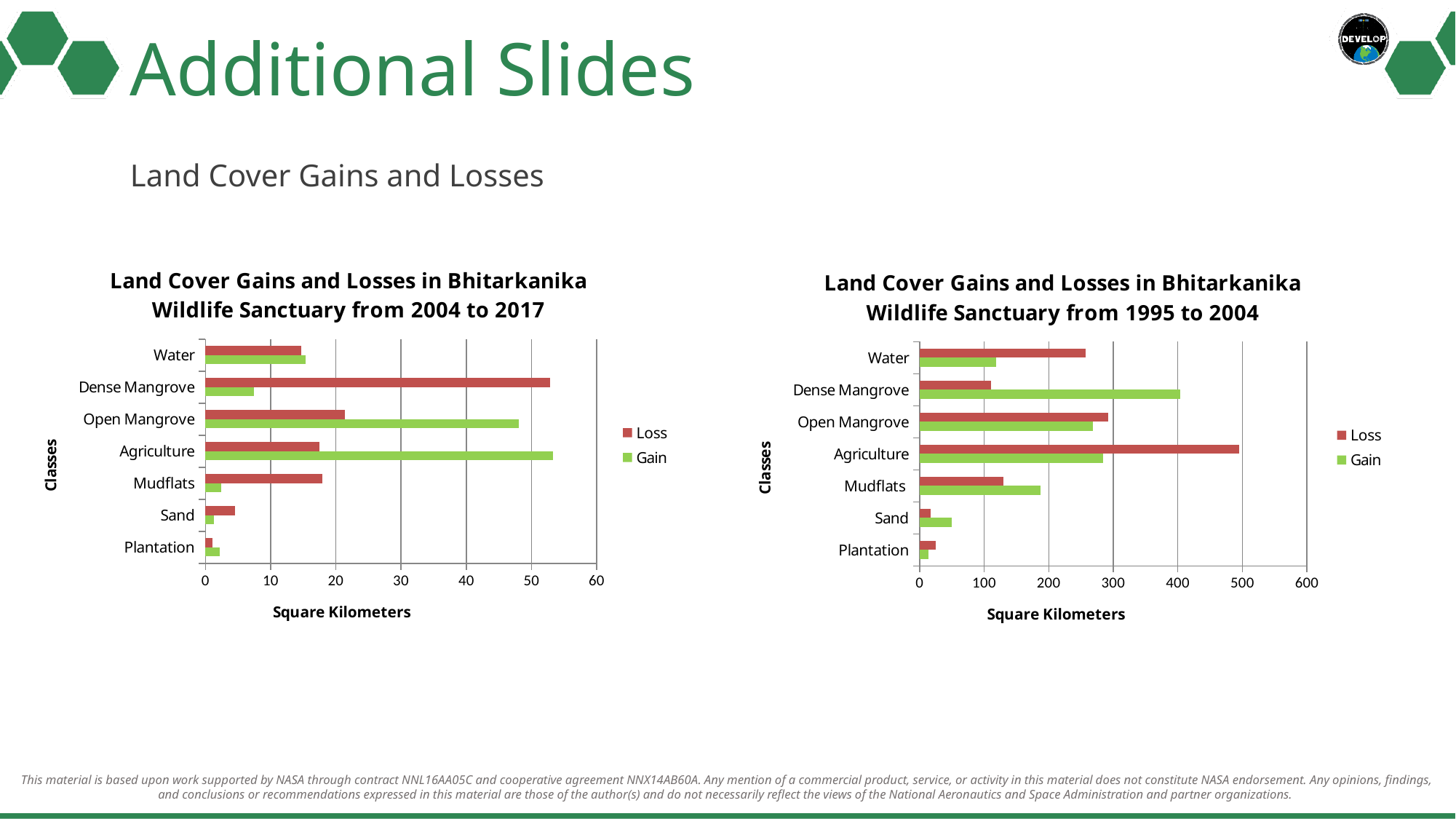
In the left chart (2004 to 2017), is the Gain or the Loss larger for Open Mangrove? Gain In the chart titled 'Land Cover Gains and Losses in Bhitarkanika Wildlife Sanctuary from 2004 to 2017', which class has the largest Gain? Agriculture In the right chart (1995 to 2004), is the Loss value for Water greater or less than 200? greater In the chart titled 'Land Cover Gains and Losses in Bhitarkanika Wildlife Sanctuary from 1995 to 2004', which class has the smallest Gain? Plantation How many land cover classes are shown in the chart titled 'Land Cover Gains and Losses in Bhitarkanika Wildlife Sanctuary from 2004 to 2017'? 7 In the left chart (2004 to 2017), is the Loss value for Dense Mangrove greater or less than 50? greater In the right chart (1995 to 2004), is the Loss value for Agriculture greater or less than 400? greater In the chart titled 'Land Cover Gains and Losses in Bhitarkanika Wildlife Sanctuary from 1995 to 2004', which class has the largest Loss? Agriculture In the chart titled 'Land Cover Gains and Losses in Bhitarkanika Wildlife Sanctuary from 1995 to 2004', which class has the largest Gain? Dense Mangrove In the right chart (1995 to 2004), is the Loss or the Gain larger for Water? Loss